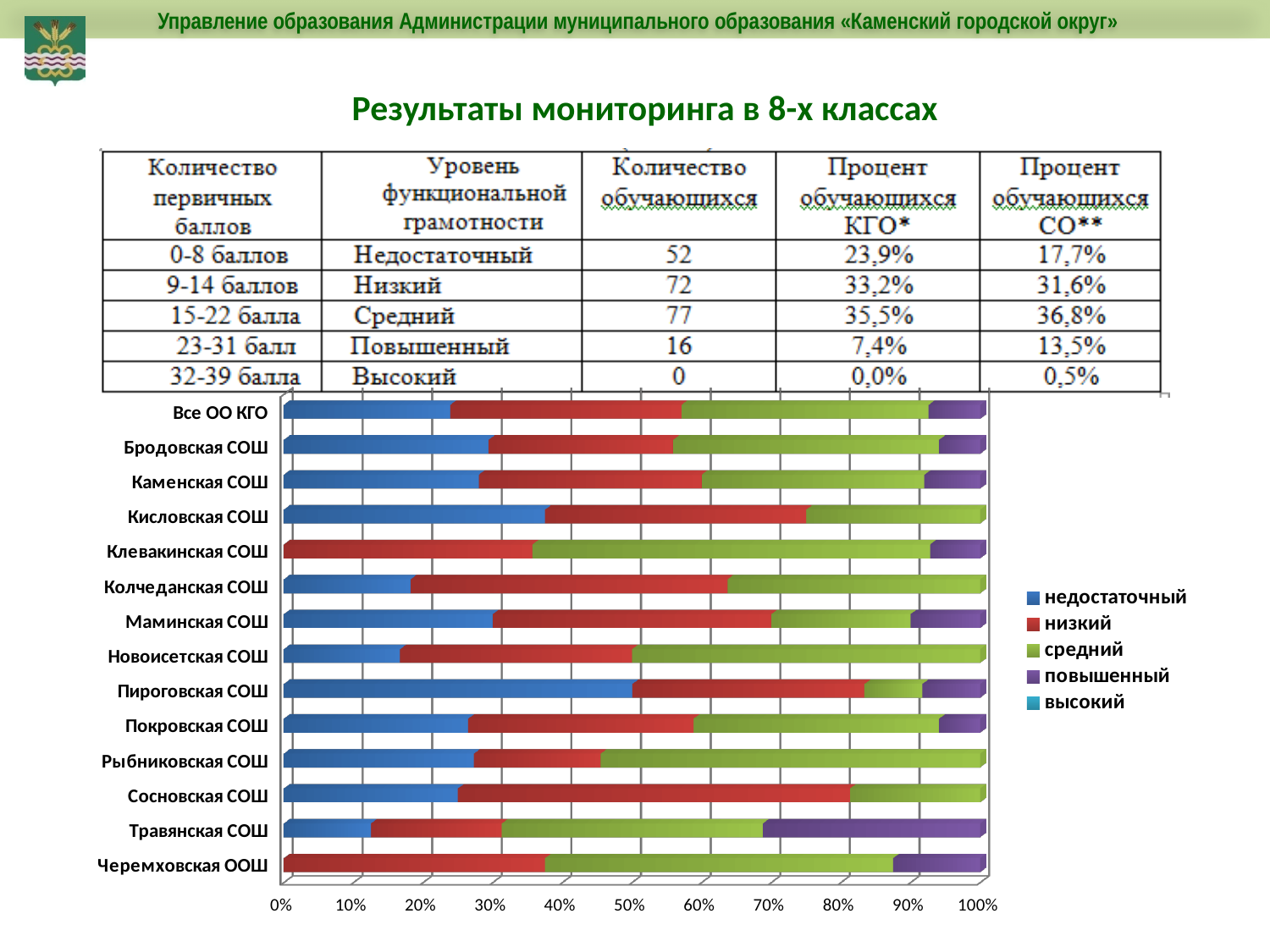
How many series does the chart legend list? 5 How many schools (categories) are plotted on the chart? 14 What kind of chart is shown on the slide? stacked bar chart Which colour represents the 'недостаточный' level in the chart? blue Is the 'недостаточный' share for Кисловская СОШ greater or less than 30%? greater Which has a larger 'недостаточный' share: Кисловская СОШ or Новоисетская СОШ? Кисловская СОШ Which school has the largest share of the 'повышенный' level? Травянская СОШ Which has a larger 'недостаточный' share: Пироговская СОШ or Травянская СОШ? Пироговская СОШ Which school has the largest share of the 'недостаточный' level? Пироговская СОШ Is the 'недостаточный' share for Все ОО КГО greater or less than 20%? greater Is the 'недостаточный' share for Травянская СОШ greater or less than 20%? less